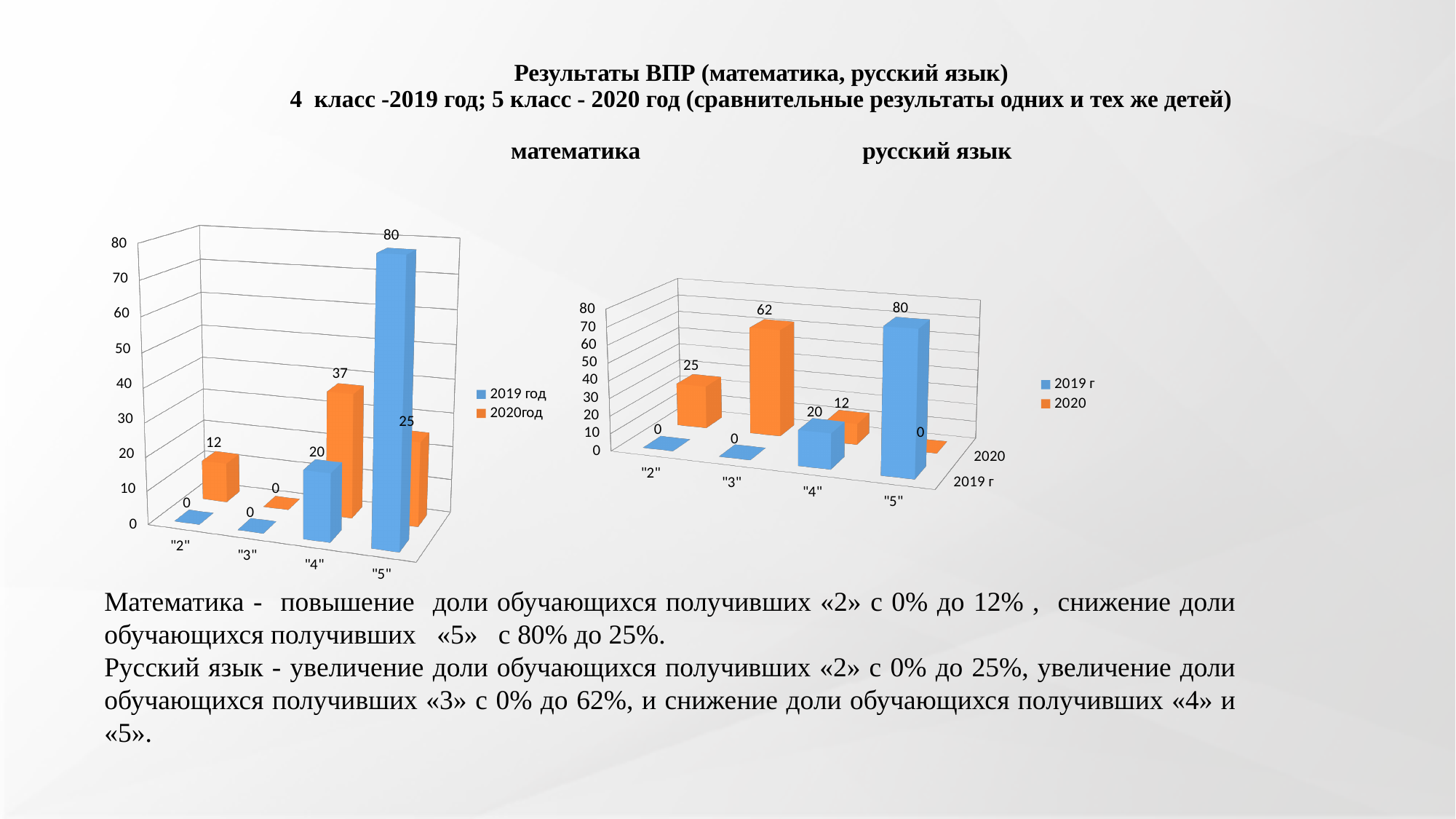
In the русский язык chart, what is the value for "4" in the 2019 г series? 20 How many series does the legend of the русский язык chart list? 2 In the математика chart, what is the difference between the 2019 год and 2020год values for "5"? 55 In the математика chart, what is the value for "4" in the 2020год series? 37 In the математика chart, what is the value for "2" in the 2020год series? 12 In the русский язык chart, which is larger for "4": the 2019 г value or the 2020 value? 2019 г In the математика chart, what is the value for "5" in the 2019 год series? 80 In the русский язык chart, what is the value for "3" in the 2020 series? 62 In the математика chart, which category has the highest value in the 2020год series? "4" In the русский язык chart, what is the difference between the 2020 values for "3" and "2"? 37 In the русский язык chart, which category has the highest value in the 2020 series? "3" How many categories are shown on the x axis of the математика chart? 4